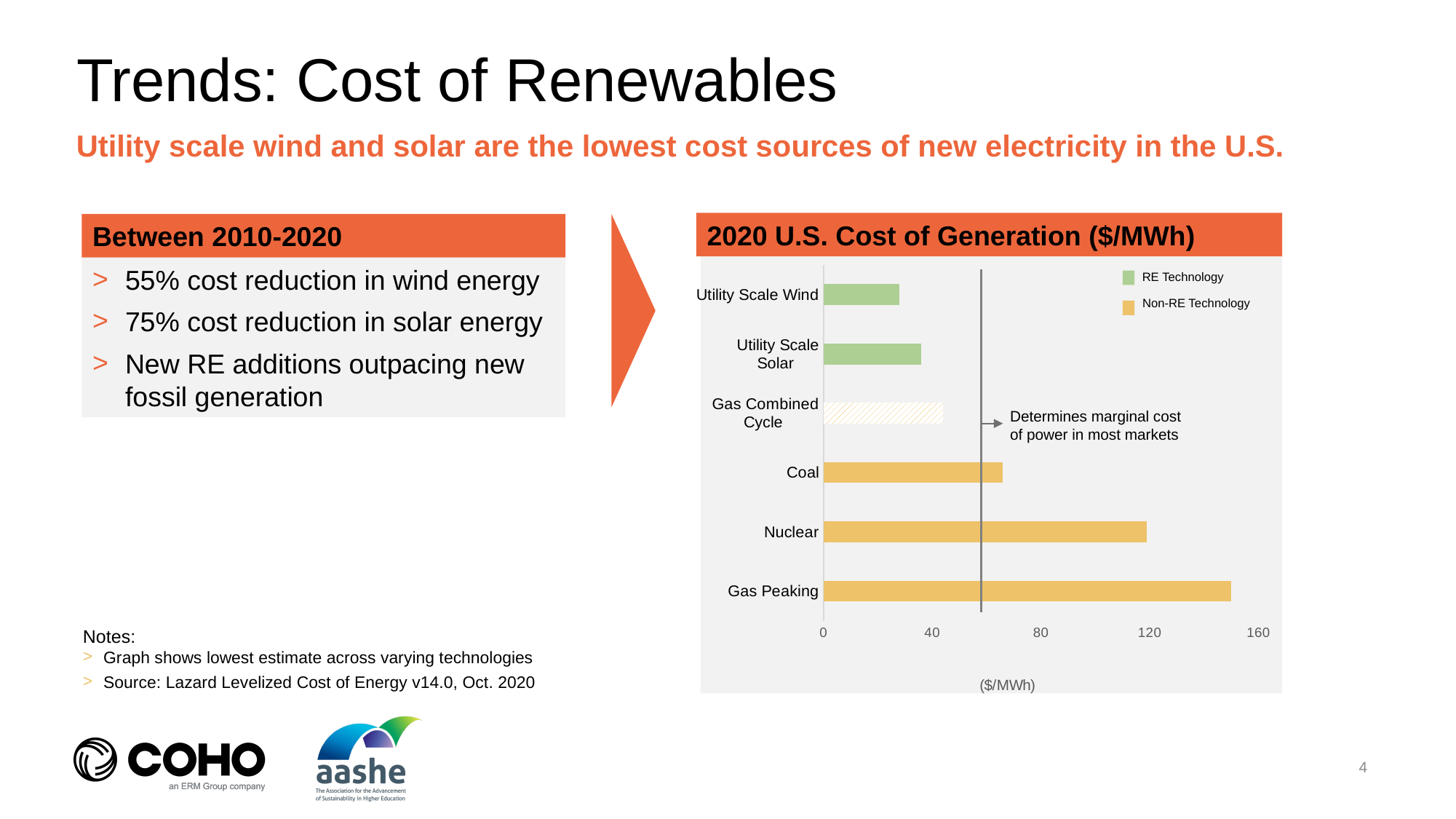
Is the value for Nuclear greater or less than 80? greater Is the value for Gas Peaking greater or less than 120? greater How many entries does the chart legend list? 2 Which technology has the lowest cost of generation in the chart? Utility Scale Wind Which technology has the highest cost of generation in the chart? Gas Peaking What kind of chart is shown on the slide? Bar chart Is the value for Coal greater or less than 80? less What is the title of the chart? 2020 U.S. Cost of Generation ($/MWh) How many generation technologies are plotted in the chart? 6 Which has a higher cost of generation, Nuclear or Coal? Nuclear Which legend entry do the green bars represent? RE Technology